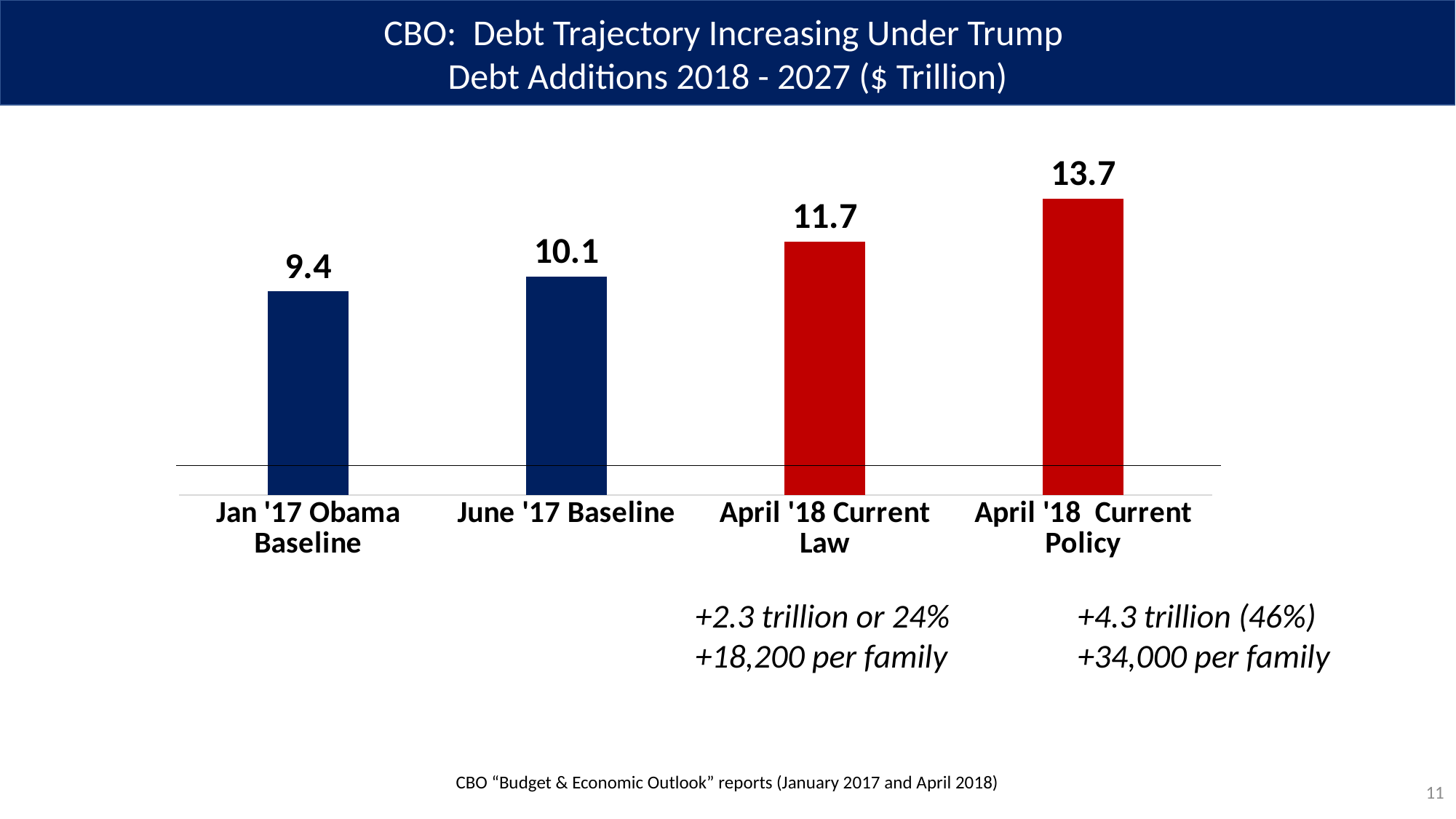
What is the difference between April '18 Current Law and June '17 Baseline? 1.6 What is the value for Jan '17 Obama Baseline? 9.4 What is the value for April '18 Current Policy? 13.7 Which category has the lowest value? Jan '17 Obama Baseline What kind of chart is shown on the slide? Bar chart Do the values rise or fall from left to right across the categories? Rise How many categories are shown in the chart? 4 Which category has the highest value? April '18 Current Policy What is the difference between April '18 Current Policy and Jan '17 Obama Baseline? 4.3 What is the value for June '17 Baseline? 10.1 Which is larger, June '17 Baseline or April '18 Current Law? April '18 Current Law What is the value for April '18 Current Law? 11.7